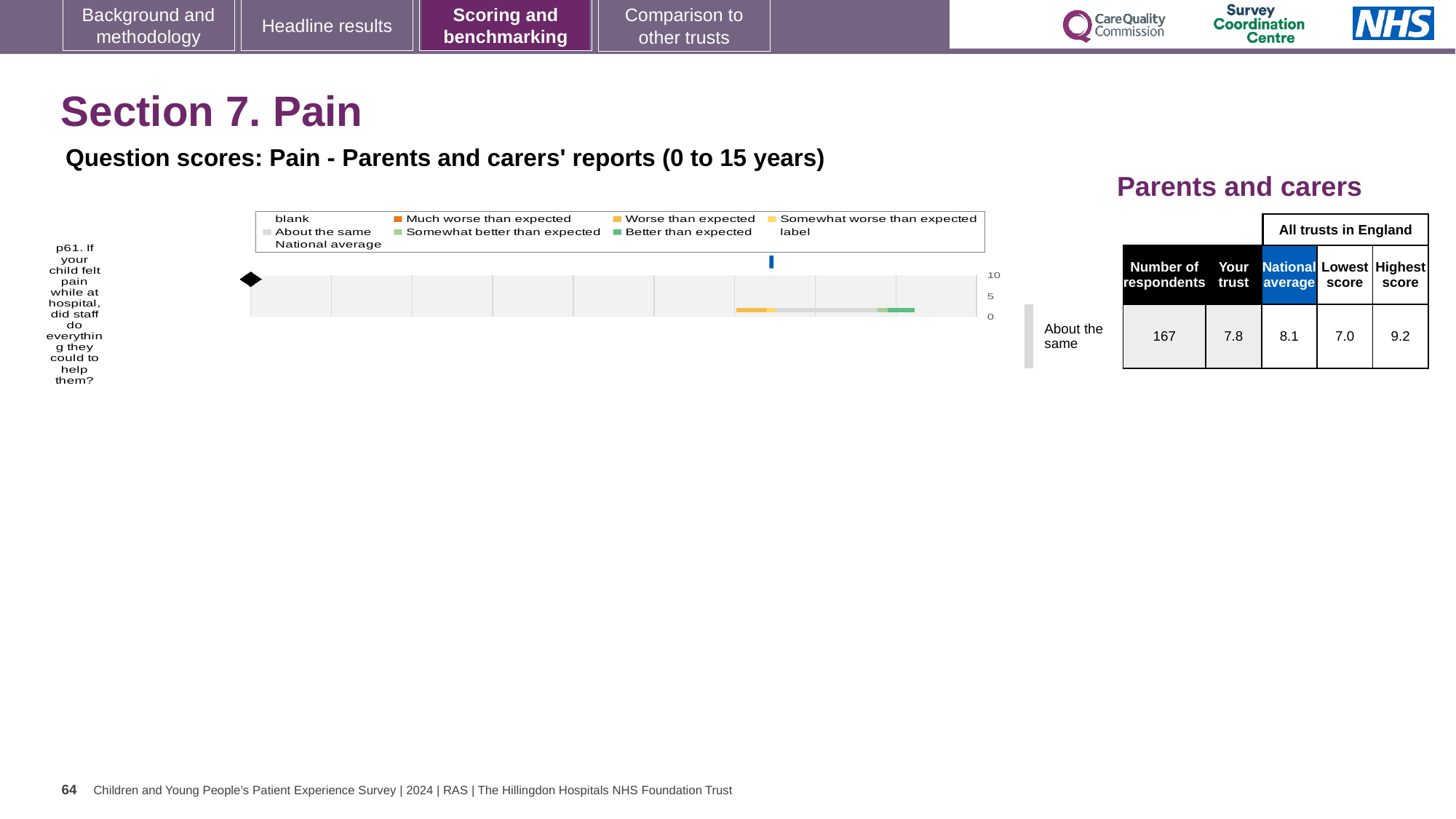
What benchmark category is the trust's result for the pain question placed in? About the same In the table next to the chart, what is the lowest score among all trusts in England? 7.0 In the table next to the chart, what is the highest score among all trusts in England? 9.2 How many questions (categories) are plotted in the chart? 1 In the table next to the chart, what is the 'Your trust' score for the question about pain? 7.8 What is the difference between the highest score and the lowest score among all trusts in England? 2.2 What kind of chart is shown on the slide? bar chart In the table next to the chart, what is the number of respondents for the question about pain? 167 Which is larger, the 'Your trust' score or the national average score? National average In the table next to the chart, what is the national average score? 8.1 What is the highest value shown on the chart's axis? 10